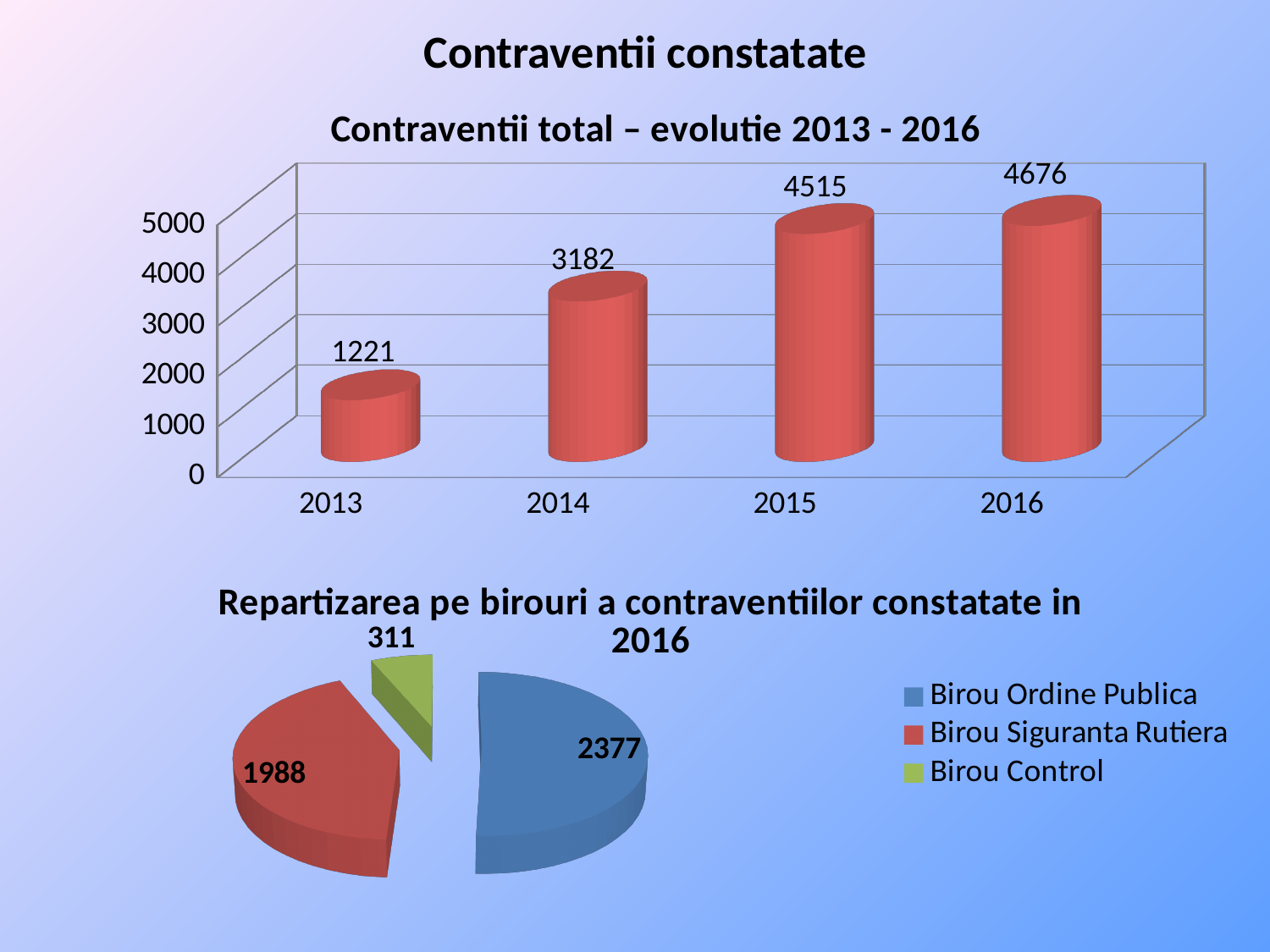
In the chart 'Contraventii total – evolutie 2013 - 2016', what is the difference between the values for 2016 and 2015? 161 In the chart 'Contraventii total – evolutie 2013 - 2016', do the values rise or fall from 2013 to 2016? rise In the pie chart 'Repartizarea pe birouri a contraventiilor constatate in 2016', how many entries does the legend list? 3 In the pie chart 'Repartizarea pe birouri a contraventiilor constatate in 2016', which is larger: Birou Ordine Publica or Birou Siguranta Rutiera? Birou Ordine Publica In the pie chart 'Repartizarea pe birouri a contraventiilor constatate in 2016', what is the value for Birou Siguranta Rutiera? 1988 In the chart 'Contraventii total – evolutie 2013 - 2016', how many years are shown? 4 In the pie chart 'Repartizarea pe birouri a contraventiilor constatate in 2016', what is the difference between Birou Ordine Publica and Birou Siguranta Rutiera? 389 In the chart 'Contraventii total – evolutie 2013 - 2016', what is the value for 2014? 3182 In the chart 'Contraventii total – evolutie 2013 - 2016', which year has the highest value? 2016 In the pie chart 'Repartizarea pe birouri a contraventiilor constatate in 2016', which office has the smallest slice? Birou Control What kind of chart is 'Contraventii total – evolutie 2013 - 2016'? bar chart In the chart 'Contraventii total – evolutie 2013 - 2016', which year has the lowest value? 2013